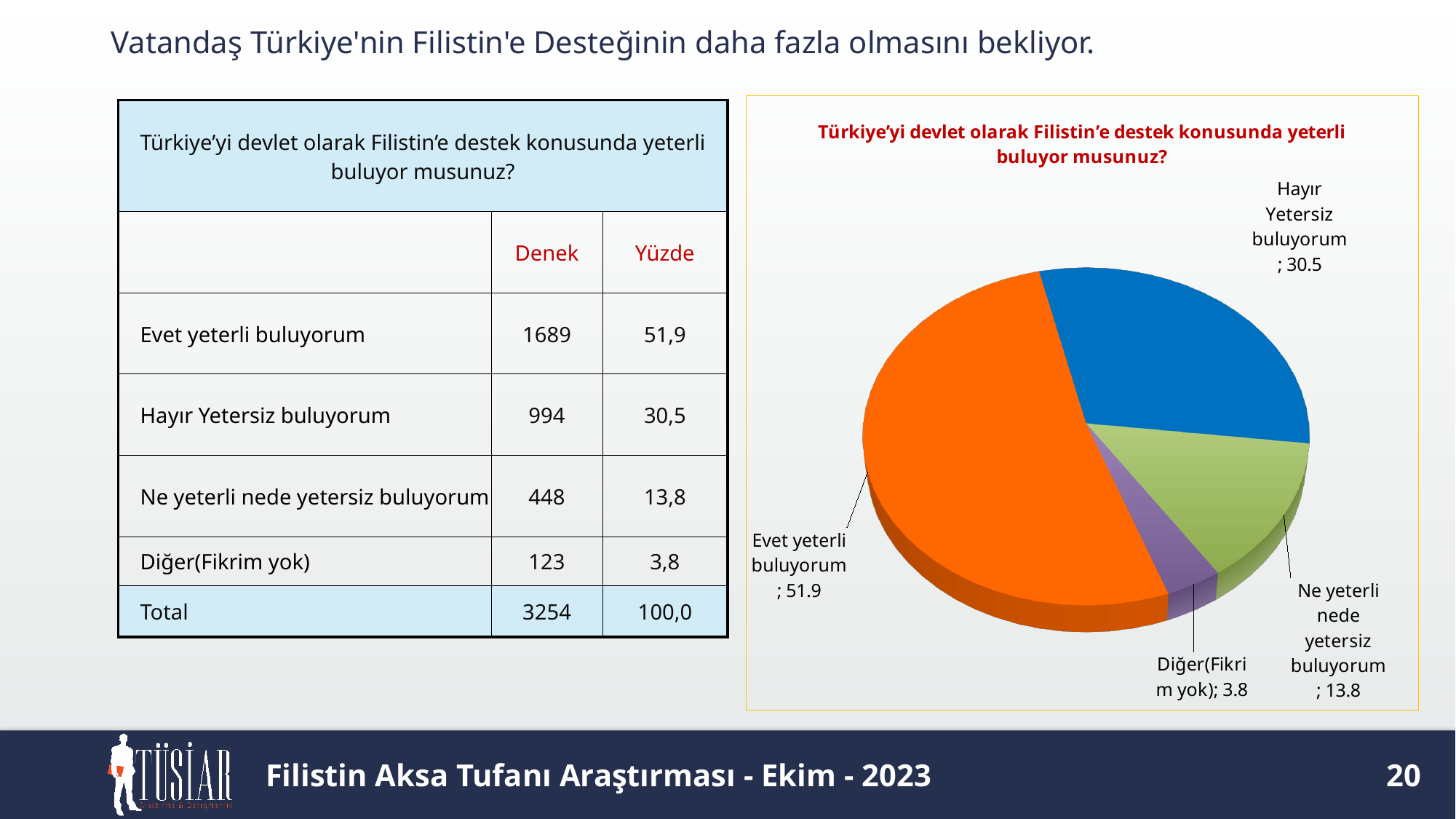
Which is larger in the pie chart: 'Hayır Yetersiz buluyorum' or 'Ne yeterli nede yetersiz buluyorum'? Hayır Yetersiz buluyorum How many slices does the pie chart have? 4 What colour is the 'Evet yeterli buluyorum' slice in the pie chart? orange Which category has the largest slice in the pie chart? Evet yeterli buluyorum What is the title of the pie chart? Türkiye'yi devlet olarak Filistin'e destek konusunda yeterli buluyor musunuz? What type of chart is shown on the slide? pie chart What is the value shown for 'Evet yeterli buluyorum' in the pie chart? 51.9 Which category has the smallest slice in the pie chart? Diğer(Fikrim yok) What is the difference between the values for 'Evet yeterli buluyorum' and 'Hayır Yetersiz buluyorum' in the pie chart? 21.4 What is the value shown for 'Hayır Yetersiz buluyorum' in the pie chart? 30.5 What is the value shown for 'Ne yeterli nede yetersiz buluyorum' in the pie chart? 13.8 What is the value shown for 'Diğer(Fikrim yok)' in the pie chart? 3.8